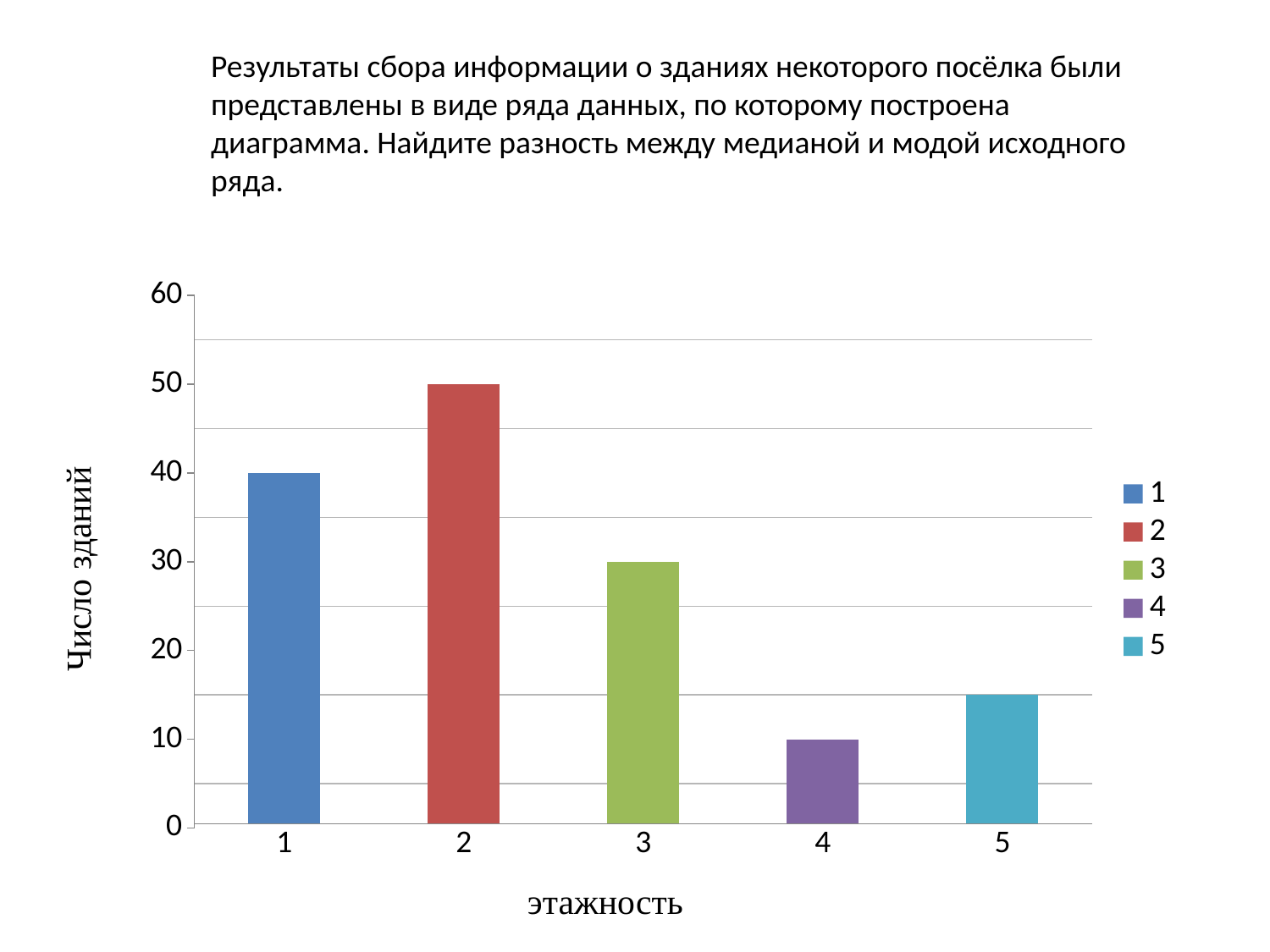
What is the difference between the number of buildings for этажность 2 and этажность 3? 20 How many categories are shown on the x axis? 5 What is the number of buildings (Число зданий) for этажность 2? 50 What is the number of buildings for этажность 4? 10 What is the number of buildings for этажность 3? 30 Which этажность category has the highest number of buildings? 2 What is the label of the vertical axis? Число зданий Is the value for этажность 5 greater or less than 20? less Which этажность category has the lowest number of buildings? 4 What type of chart is shown on the slide? bar chart What is the number of buildings for этажность 1? 40 Which has more buildings: этажность 1 or этажность 3? этажность 1